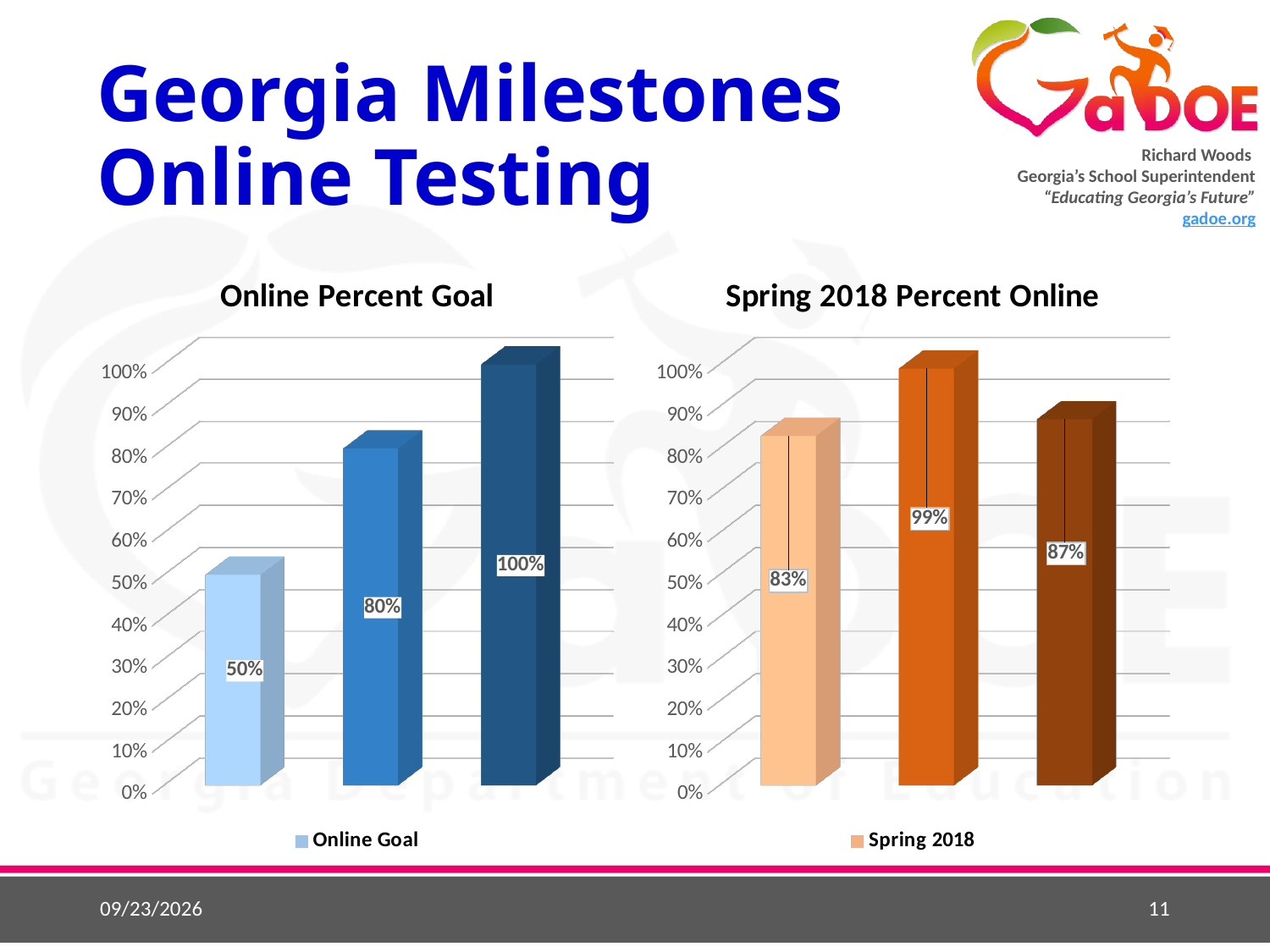
In the 'Online Percent Goal' chart, what is the difference between the rightmost bar and the leftmost bar? 50% In the 'Online Percent Goal' chart, what value is labelled on the rightmost bar? 100% In the 'Spring 2018 Percent Online' chart, which bar has the highest value? The middle bar (99%) How many bars are plotted in the 'Online Percent Goal' chart? 3 In the 'Spring 2018 Percent Online' chart, which bar has the lowest value? The leftmost bar (83%) What type of chart is the 'Spring 2018 Percent Online' chart? Bar chart In the 'Spring 2018 Percent Online' chart, what is the difference between the middle bar and the rightmost bar? 12% In the 'Spring 2018 Percent Online' chart, what value is labelled on the middle bar? 99% In the 'Online Percent Goal' chart, what value is labelled on the leftmost bar? 50% Do the values in the 'Online Percent Goal' chart rise or fall from left to right? Rise In the 'Spring 2018 Percent Online' chart, is the rightmost bar (87%) larger or smaller than the leftmost bar (83%)? Larger In the 'Spring 2018 Percent Online' chart, what value is labelled on the leftmost bar? 83%